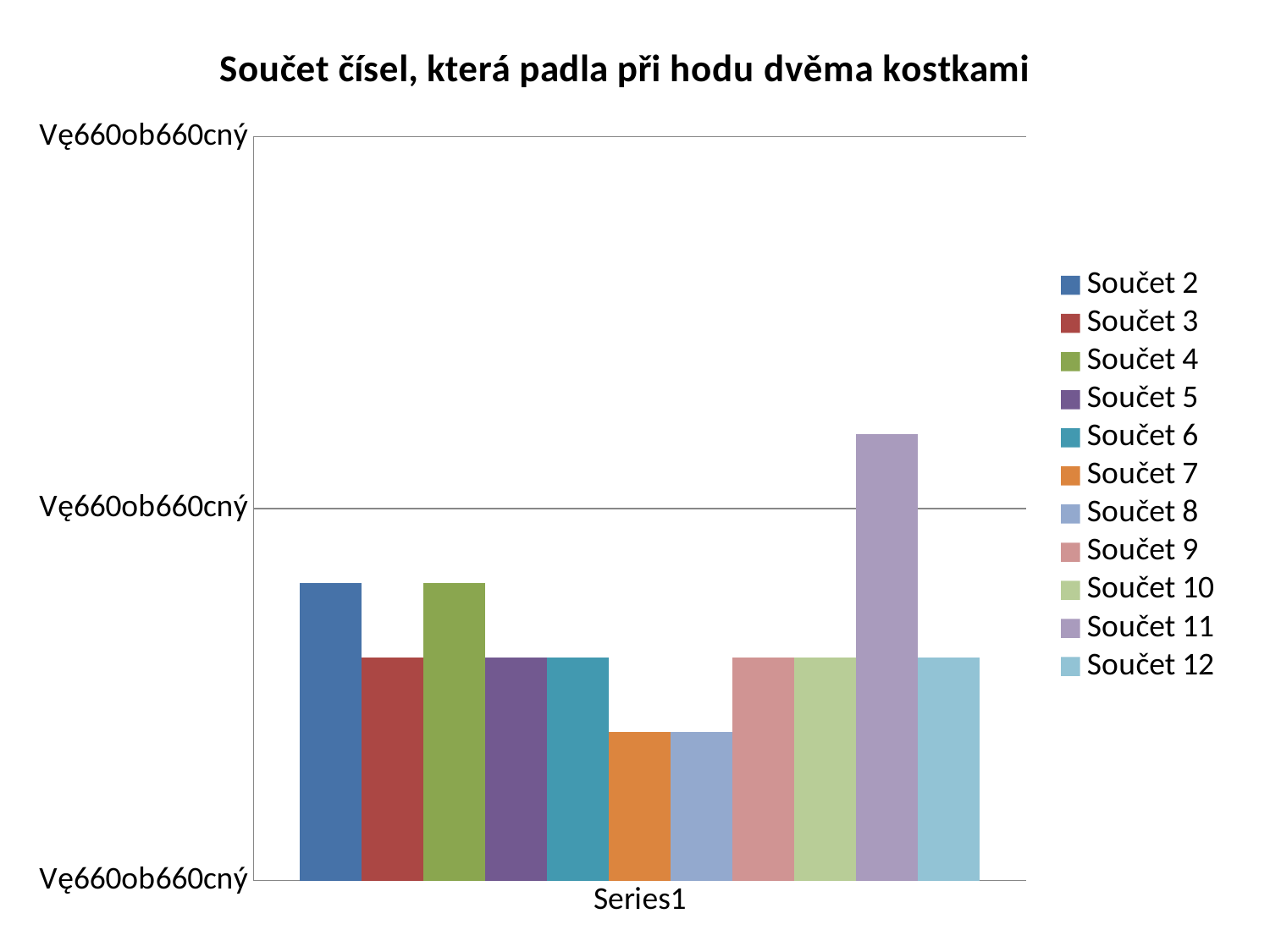
Which is larger, the bar for Součet 7 or the bar for Součet 9? Součet 9 Which is larger, the bar for Součet 2 or the bar for Součet 3? Součet 2 How many bars are plotted in the chart? 11 Which is larger, the bar for Součet 11 or the bar for Součet 4? Součet 11 What type of chart is shown on the slide? Bar chart How many series does the legend list? 11 Which series has the tallest bar? Součet 11 What label appears on the horizontal axis under the bars? Series1 What is the title of the chart? Součet čísel, která padla při hodu dvěma kostkami